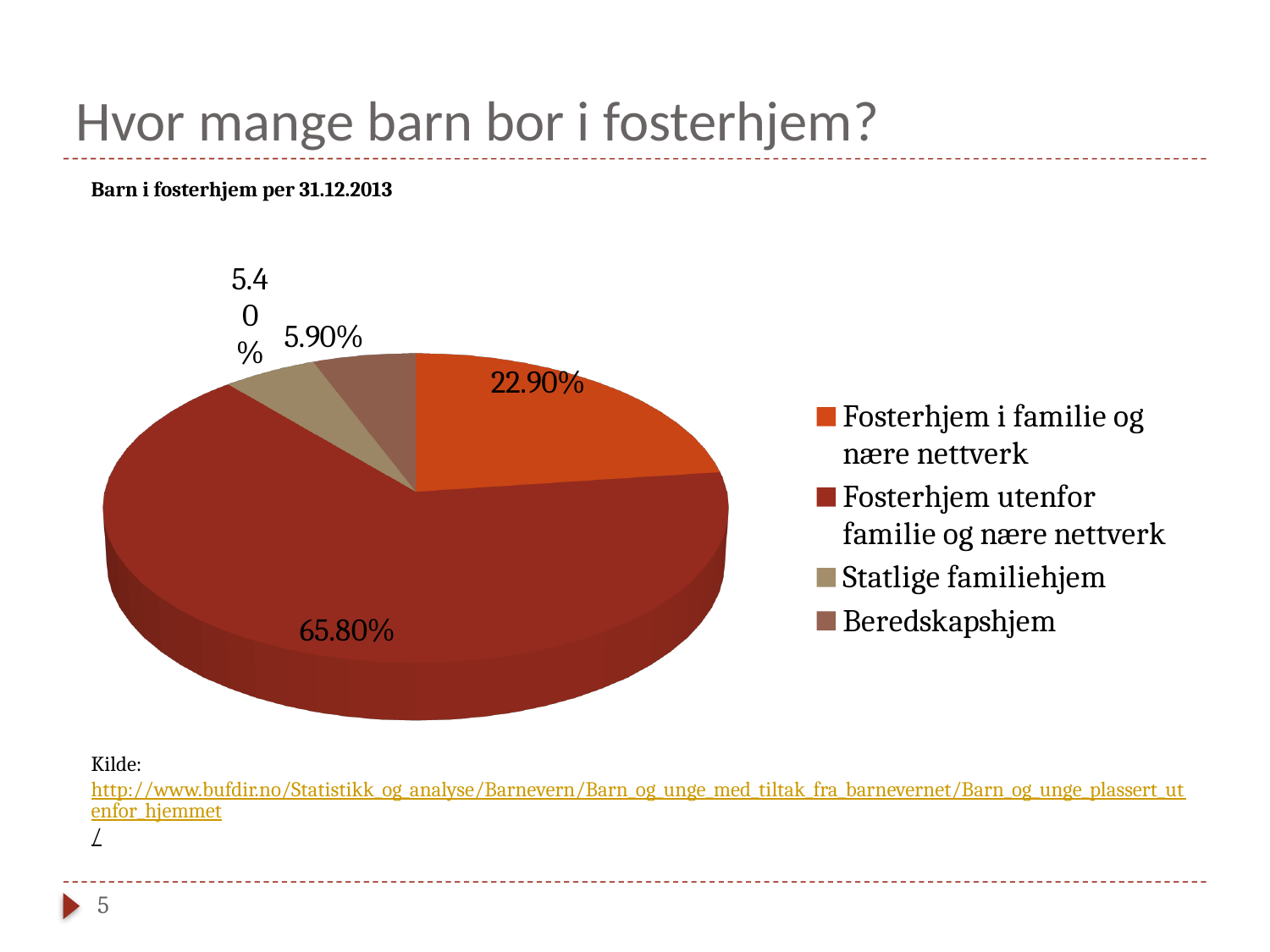
How many categories does the legend list? 4 How many slices does the pie chart have? 4 What is the difference in percentage points between 'Fosterhjem utenfor familie og nære nettverk' and 'Fosterhjem i familie og nære nettverk'? 42.90% What type of chart is shown on the slide? pie chart What share of the pie is 'Beredskapshjem'? 5.90% Which is larger, the share for 'Beredskapshjem' or the share for 'Statlige familiehjem'? Beredskapshjem Which category has the smallest slice of the pie? Statlige familiehjem What share of the pie is 'Fosterhjem utenfor familie og nære nettverk'? 65.80% Which category has the largest slice of the pie? Fosterhjem utenfor familie og nære nettverk What share of the pie is 'Fosterhjem i familie og nære nettverk'? 22.90% What is the chart's title? Barn i fosterhjem per 31.12.2013